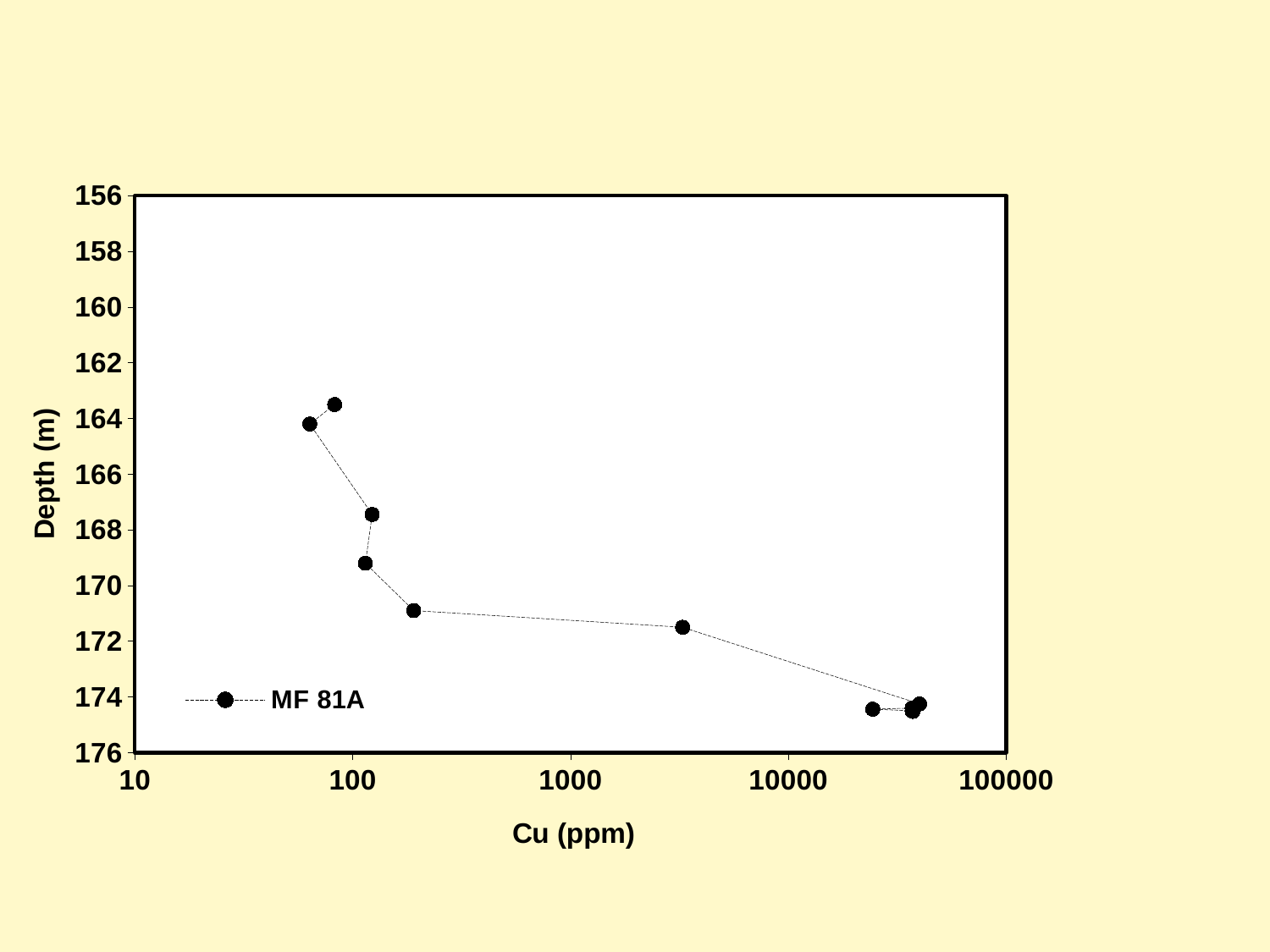
Is the Cu value for the point at about 167.5 m depth greater or less than 1000 ppm? less Is the Cu value for the point at about 171 m depth greater or less than 100 ppm? greater Is the Cu value for the deepest points (around 174 m) greater or less than 10000 ppm? greater Which has the higher Cu value: the point at about 171.5 m depth or the point at about 169 m depth? The point at about 171.5 m depth How many series does the legend list? 1 Does the Cu concentration generally increase or decrease as depth increases from 164 m to 174 m? Increase What is the name of the series shown in the legend? MF 81A What kind of chart is shown on the slide? Scatter (line) chart What is the label of the x axis? Cu (ppm)